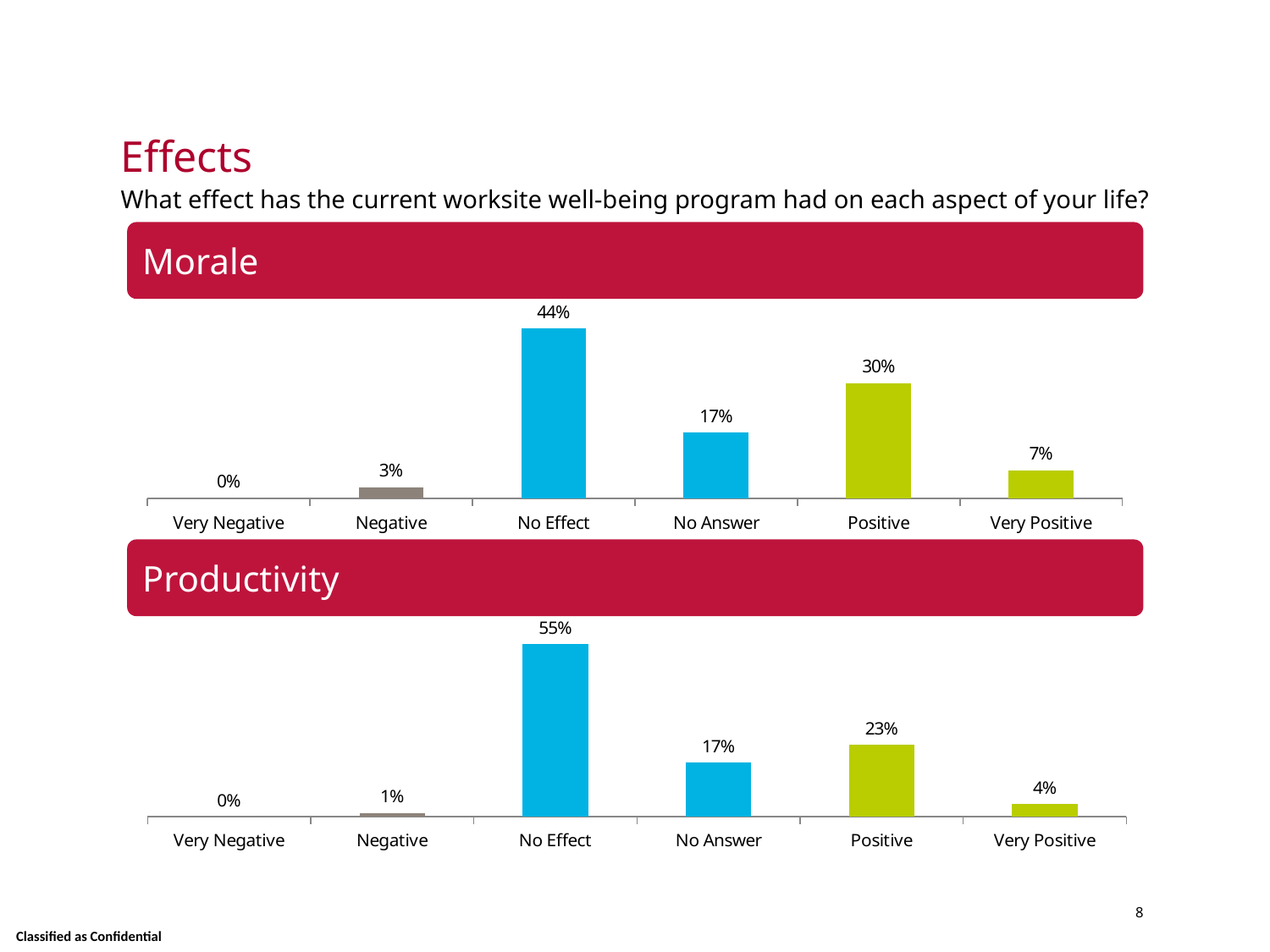
In the Productivity chart, what is the value for Negative? 1% In the Productivity chart, which category has the highest value? No Effect How many categories are shown in the Productivity chart? 6 In the Morale chart, which is larger, No Answer or Positive? Positive In the Morale chart, what is the difference between No Effect and Positive? 14% In the Productivity chart, what is the difference between No Effect and No Answer? 38% What kind of chart is the Morale chart? Bar chart In the Morale chart, which category has the lowest value? Very Negative In the Productivity chart, which is larger, Negative or Very Positive? Very Positive In the Morale chart, what is the value for No Effect? 44% In the Morale chart, what is the value for Very Positive? 7% In the Productivity chart, what is the value for Positive? 23%